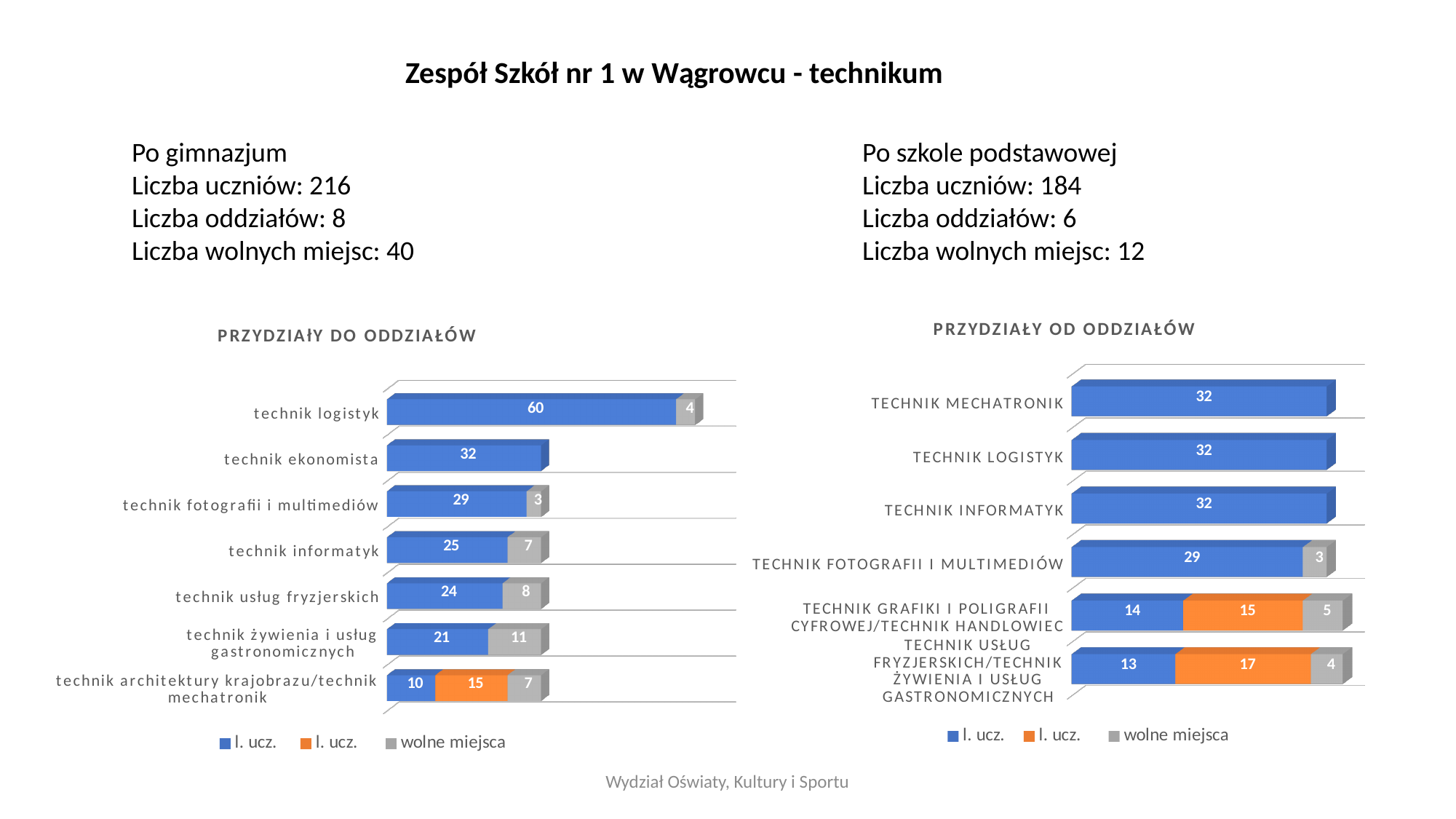
In the right chart (PRZYDZIAŁY OD ODDZIAŁÓW), what is the orange value for TECHNIK USŁUG FRYZJERSKICH/TECHNIK ŻYWIENIA I USŁUG GASTRONOMICZNYCH? 17 In the left chart (PRZYDZIAŁY DO ODDZIAŁÓW), what is the blue 'l. ucz.' value for technik logistyk? 60 In the right chart (PRZYDZIAŁY OD ODDZIAŁÓW), what is the blue 'l. ucz.' value for TECHNIK MECHATRONIK? 32 In the right chart (PRZYDZIAŁY OD ODDZIAŁÓW), how many categories are plotted? 6 In the left chart (PRZYDZIAŁY DO ODDZIAŁÓW), what is the difference between the blue values for technik ekonomista and technik informatyk? 7 What type of chart is the left chart (PRZYDZIAŁY DO ODDZIAŁÓW)? Stacked bar chart In the left chart (PRZYDZIAŁY DO ODDZIAŁÓW), how many categories are plotted? 7 In the left chart (PRZYDZIAŁY DO ODDZIAŁÓW), which category has the highest blue 'l. ucz.' value? technik logistyk In the left chart (PRZYDZIAŁY DO ODDZIAŁÓW), what is the total of the stacked bar for technik architektury krajobrazu/technik mechatronik? 32 In the left chart (PRZYDZIAŁY DO ODDZIAŁÓW), how many 'wolne miejsca' are shown for technik żywienia i usług gastronomicznych? 11 In the right chart (PRZYDZIAŁY OD ODDZIAŁÓW), what is the total of the stacked bar for TECHNIK GRAFIKI I POLIGRAFII CYFROWEJ/TECHNIK HANDLOWIEC? 34 How many series does the legend of the right chart (PRZYDZIAŁY OD ODDZIAŁÓW) list? 3